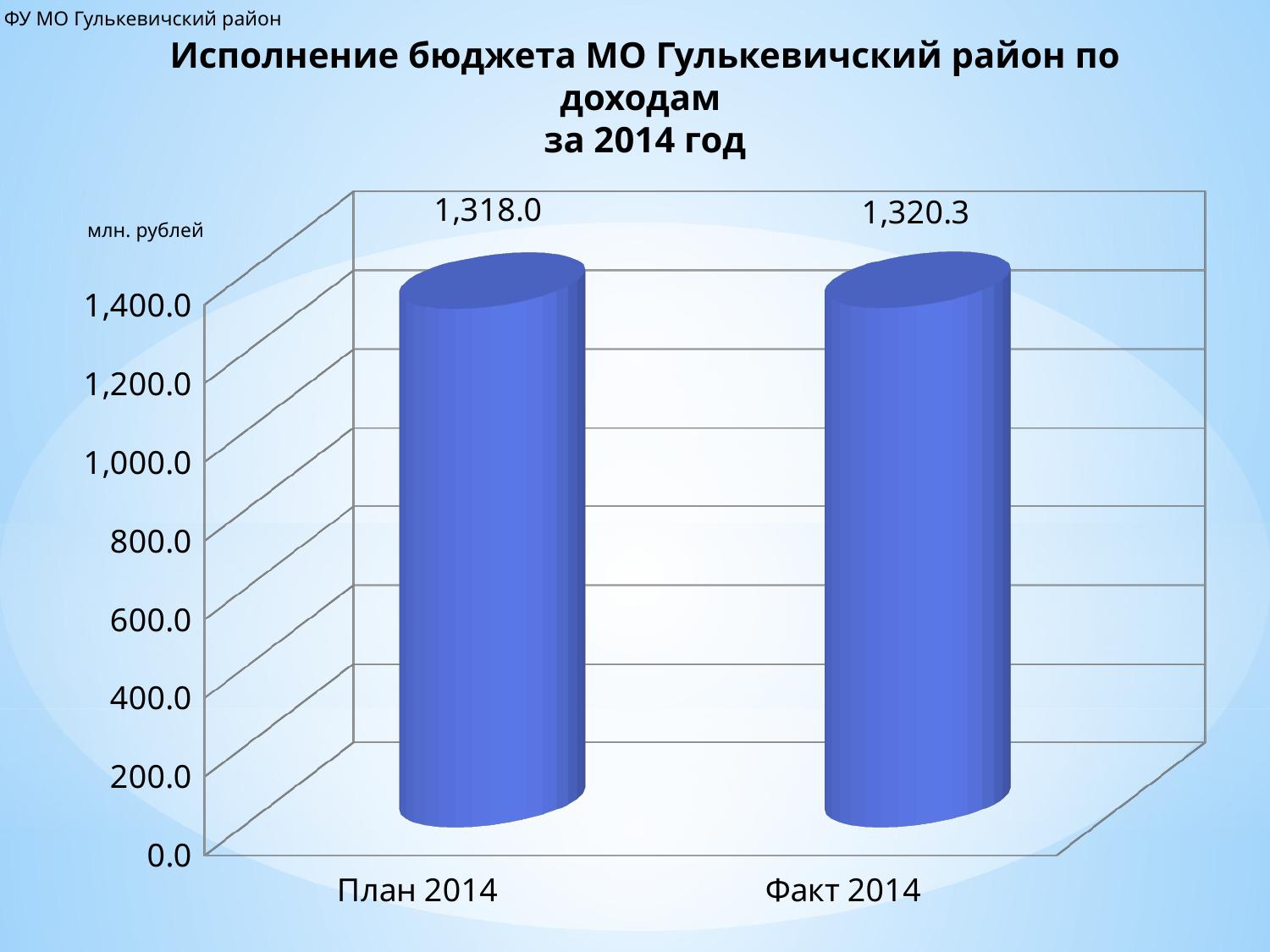
Is the value for План 2014 greater or less than 1,200.0? greater Which category has the higher value, План 2014 or Факт 2014? Факт 2014 What unit is indicated for the values on the chart? млн. рублей Is the value for Факт 2014 greater or less than 1,400.0? less What is the difference between the values for Факт 2014 and План 2014? 2.3 Which category has the highest value? Факт 2014 What is the value for Факт 2014? 1,320.3 How many categories are shown on the chart? 2 What kind of chart is shown on the slide? bar chart What is the title of the chart? Исполнение бюджета МО Гулькевичский район по доходам за 2014 год What is the value for План 2014? 1,318.0 Which category has the lowest value? План 2014